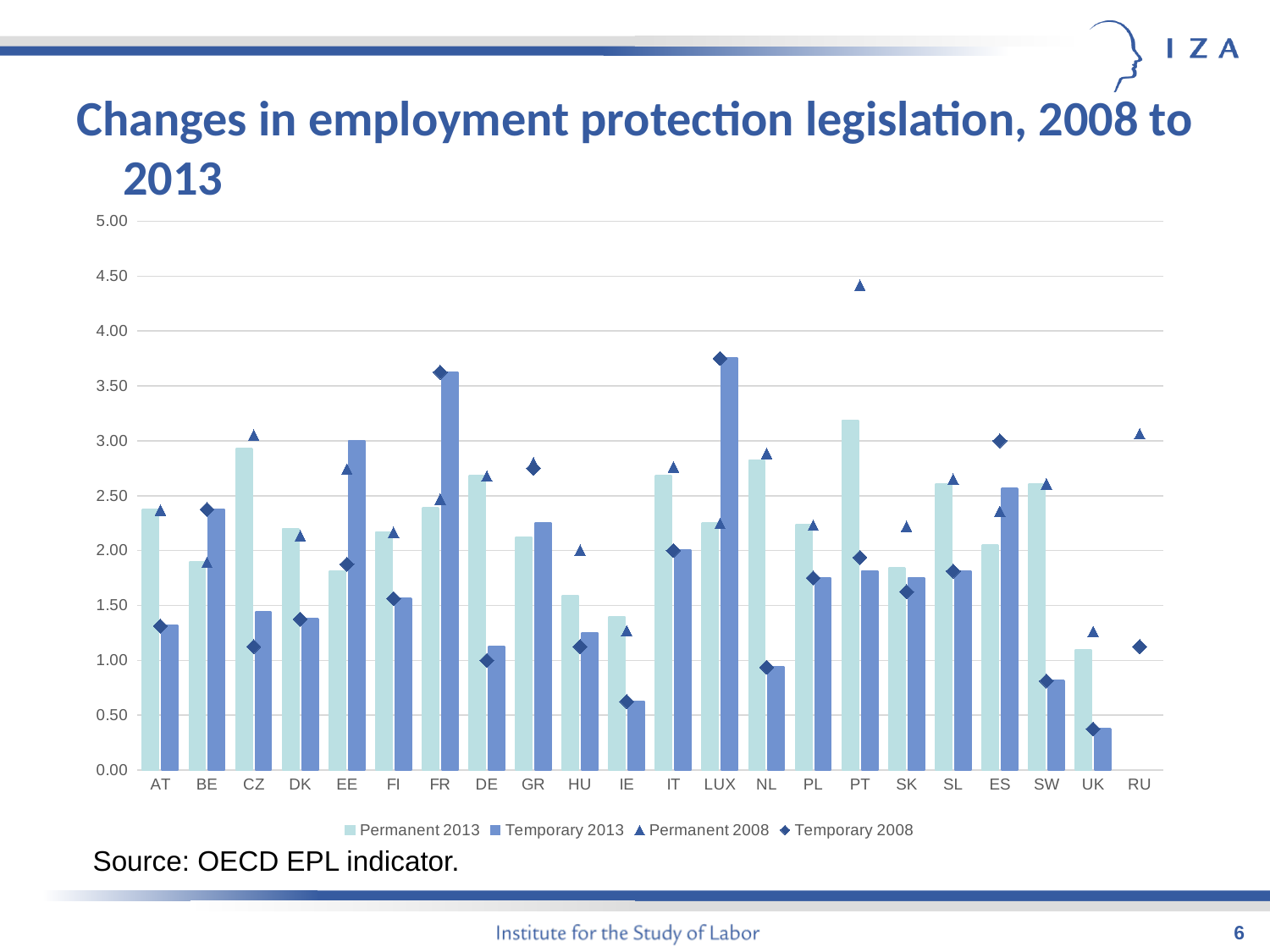
Is the Permanent 2013 value for CZ greater or less than 2.50? greater For DE, which is larger: the Permanent 2013 bar or the Temporary 2013 bar? Permanent 2013 Which marker shape is used for the Permanent 2008 series? triangle Is the Temporary 2013 value for UK greater or less than 0.50? less Which country has the lowest Temporary 2013 bar? UK Is the Permanent 2008 value for PT greater or less than 4.00? greater How many series does the legend list? 4 Which country has the highest Temporary 2013 bar? LUX Which country has the highest Permanent 2013 bar? PT What kind of chart is this? bar chart How many countries are shown on the x axis? 22 Which country has the highest Permanent 2008 marker? PT